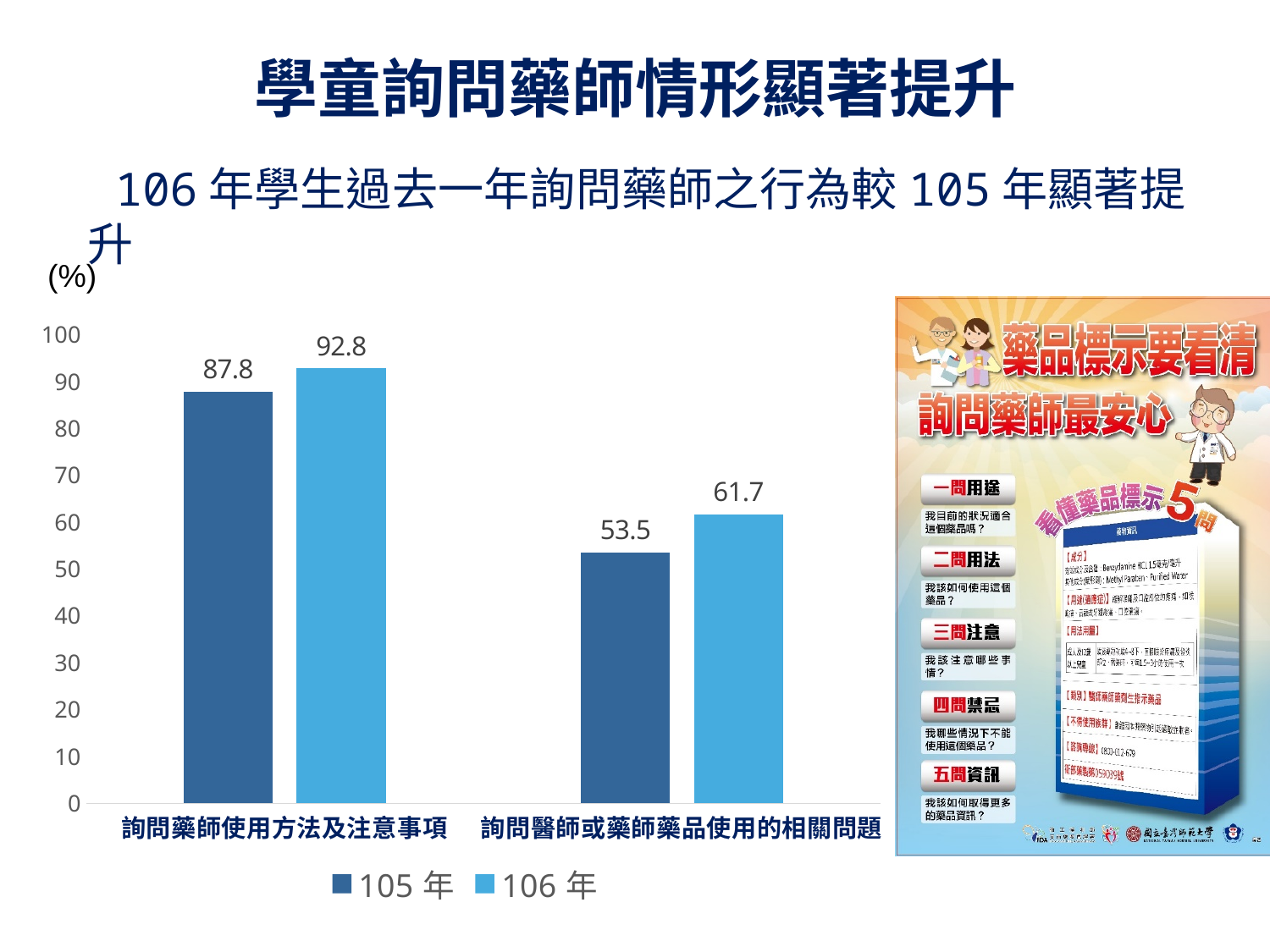
Which bar has the lowest value on the chart? 105 年, 詢問醫師或藥師藥品使用的相關問題 What is the difference between the 106 年 and 105 年 values for 詢問醫師或藥師藥品使用的相關問題? 8.2 How many series does the legend list? 2 What kind of chart is shown on the slide? bar chart What is the value for 105 年 in the category 詢問藥師使用方法及注意事項? 87.8 What is the value for 106 年 in the category 詢問醫師或藥師藥品使用的相關問題? 61.7 Which bar has the highest value on the chart? 106 年, 詢問藥師使用方法及注意事項 What is the difference between the 106 年 and 105 年 values for 詢問藥師使用方法及注意事項? 5 What is the value for 106 年 in the category 詢問藥師使用方法及注意事項? 92.8 What is the value for 105 年 in the category 詢問醫師或藥師藥品使用的相關問題? 53.5 How many categories are shown on the x axis of the chart? 2 For 詢問醫師或藥師藥品使用的相關問題, which series has the larger value, 105 年 or 106 年? 106 年